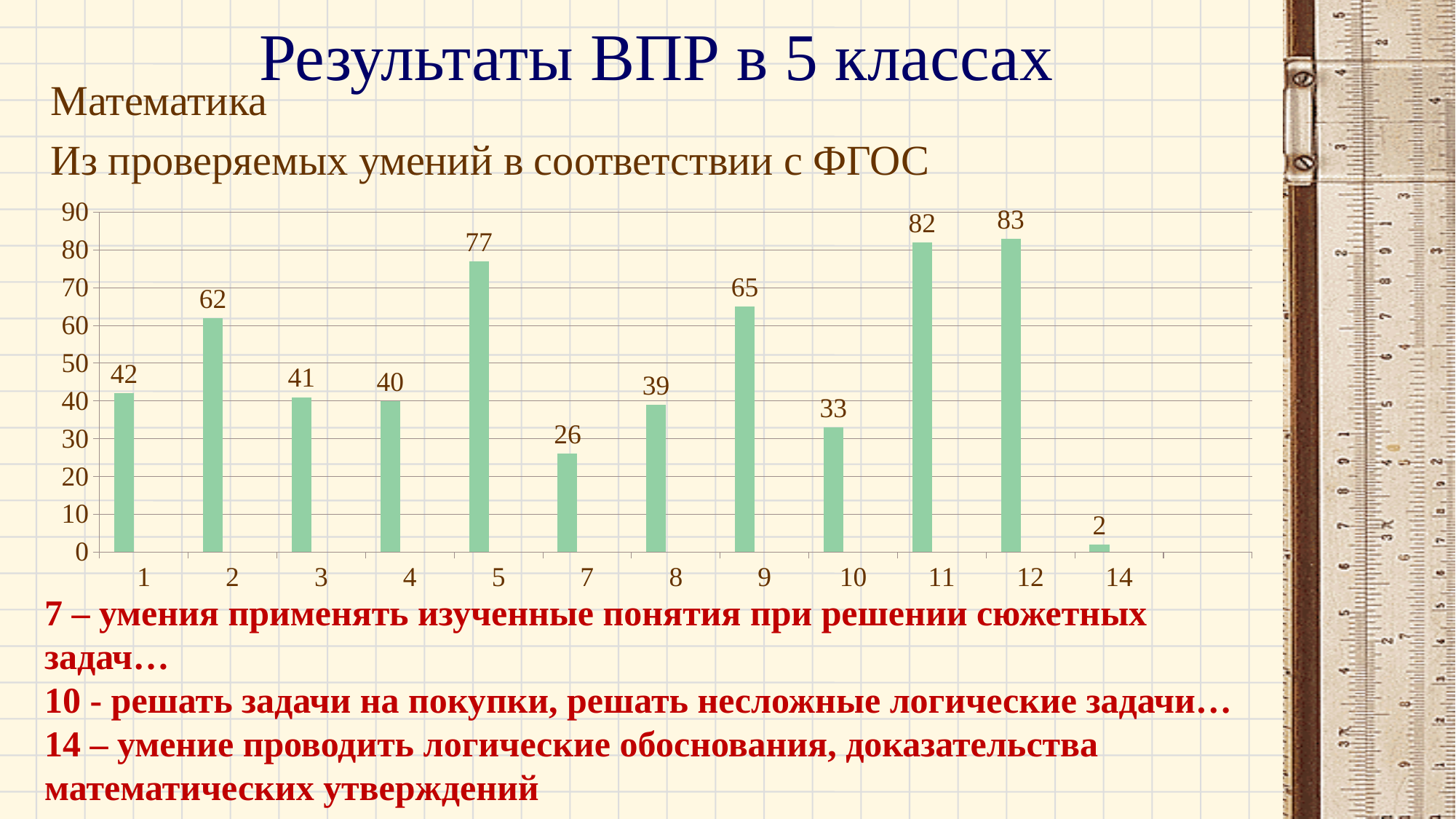
What is the value for category 10? 33 Which is larger, the value for category 2 or the value for category 9? 9 Which category has the lowest value? 14 How many bars are plotted in the chart? 12 What kind of chart is shown on the slide? bar chart What is the difference between the values for category 1 and category 3? 1 Is the value for category 8 greater or less than 40? less What is the highest value shown on the vertical axis? 90 What is the value for category 14? 2 Which category has the highest value? 12 What is the difference between the values for category 11 and category 7? 56 What is the value for category 5? 77